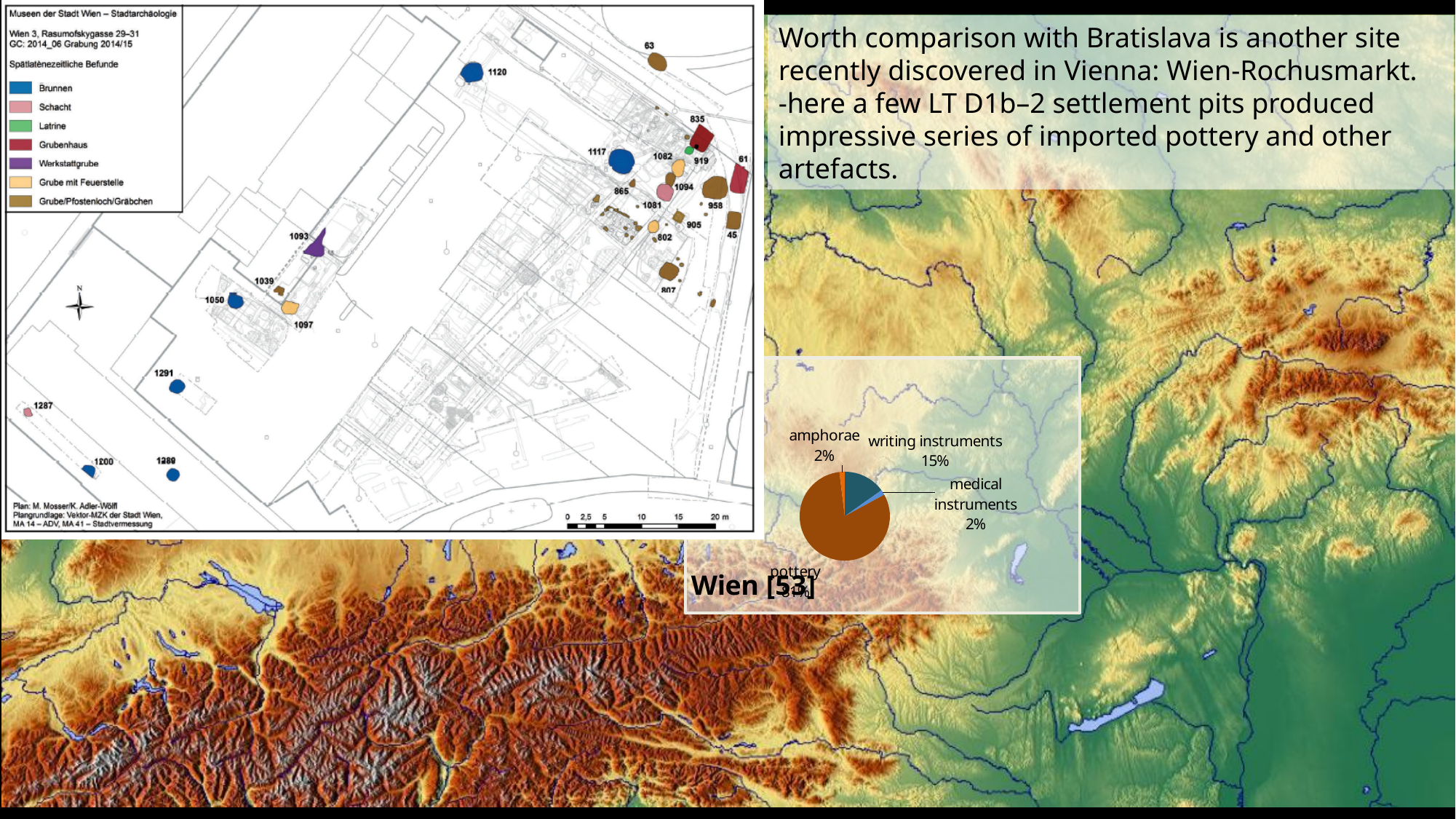
In the pie chart, which is larger: writing instruments or amphorae? writing instruments In the pie chart, what share is labelled for medical instruments? 2% Which category takes the largest slice of the pie chart? pottery In the pie chart, what is the difference between the shares for writing instruments and medical instruments? 13% In the pie chart, which is larger: pottery or writing instruments? pottery In the pie chart, what is the combined share of amphorae and medical instruments? 4% How many categories are shown in the pie chart? 4 In the pie chart, what share is labelled for amphorae? 2% What colour is the pottery slice in the pie chart? brown What kind of chart is shown in the inset on the right side of the slide? pie chart In the pie chart, what share is labelled for writing instruments? 15%